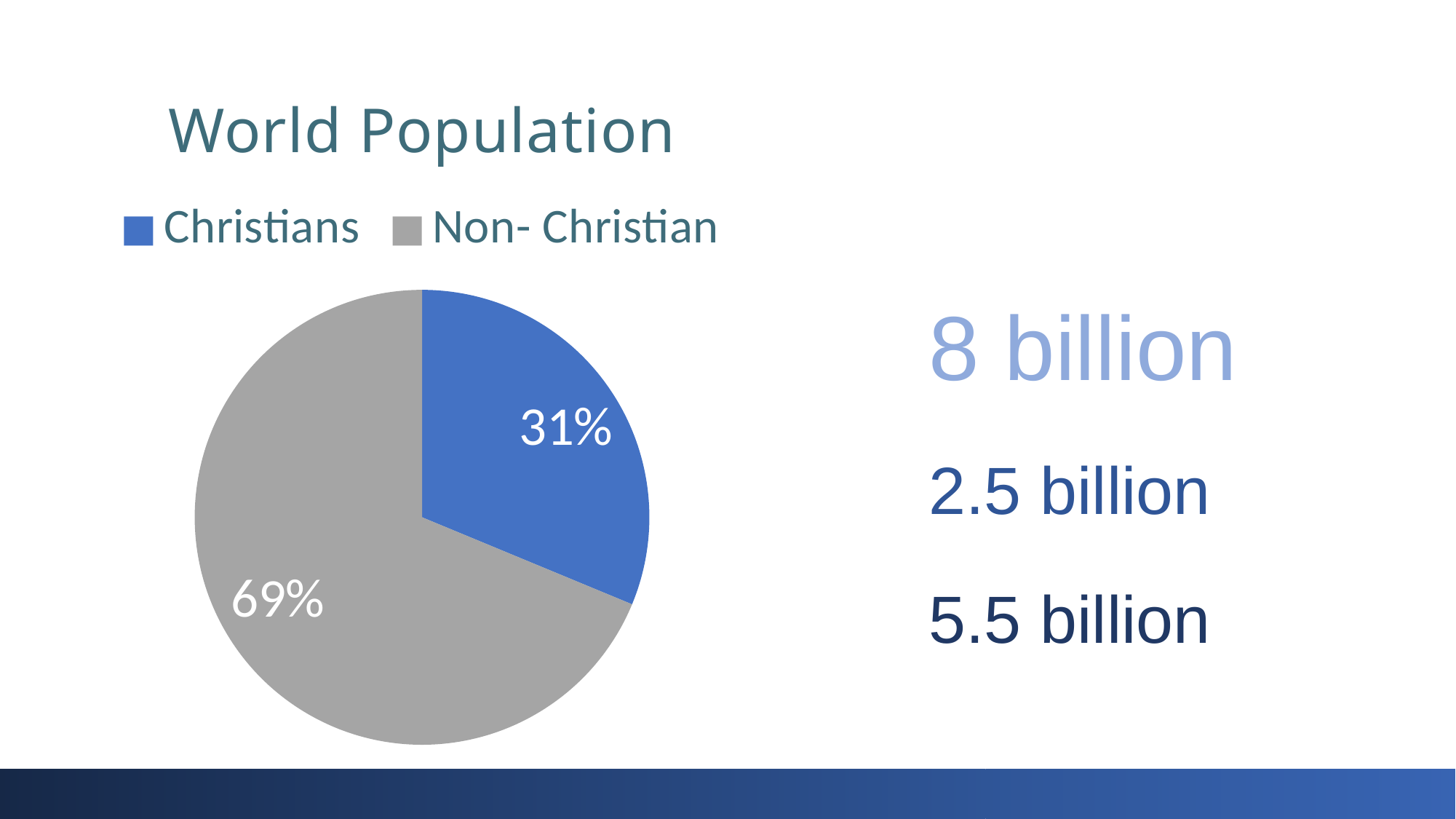
How many slices does the pie chart have? 2 What is the difference in percentage points between the Non- Christian slice and the Christians slice? 38 What is the title of the chart? World Population What share of the pie is labelled for Christians? 31% What kind of chart is shown on the slide? pie chart Which is larger, the Christians slice or the Non- Christian slice? Non- Christian How many entries does the legend list? 2 What colour is the Christians slice in the pie chart? blue Which slice of the pie is the smallest? Christians What share of the pie is labelled for Non- Christian? 69% Which slice of the pie is the largest? Non- Christian